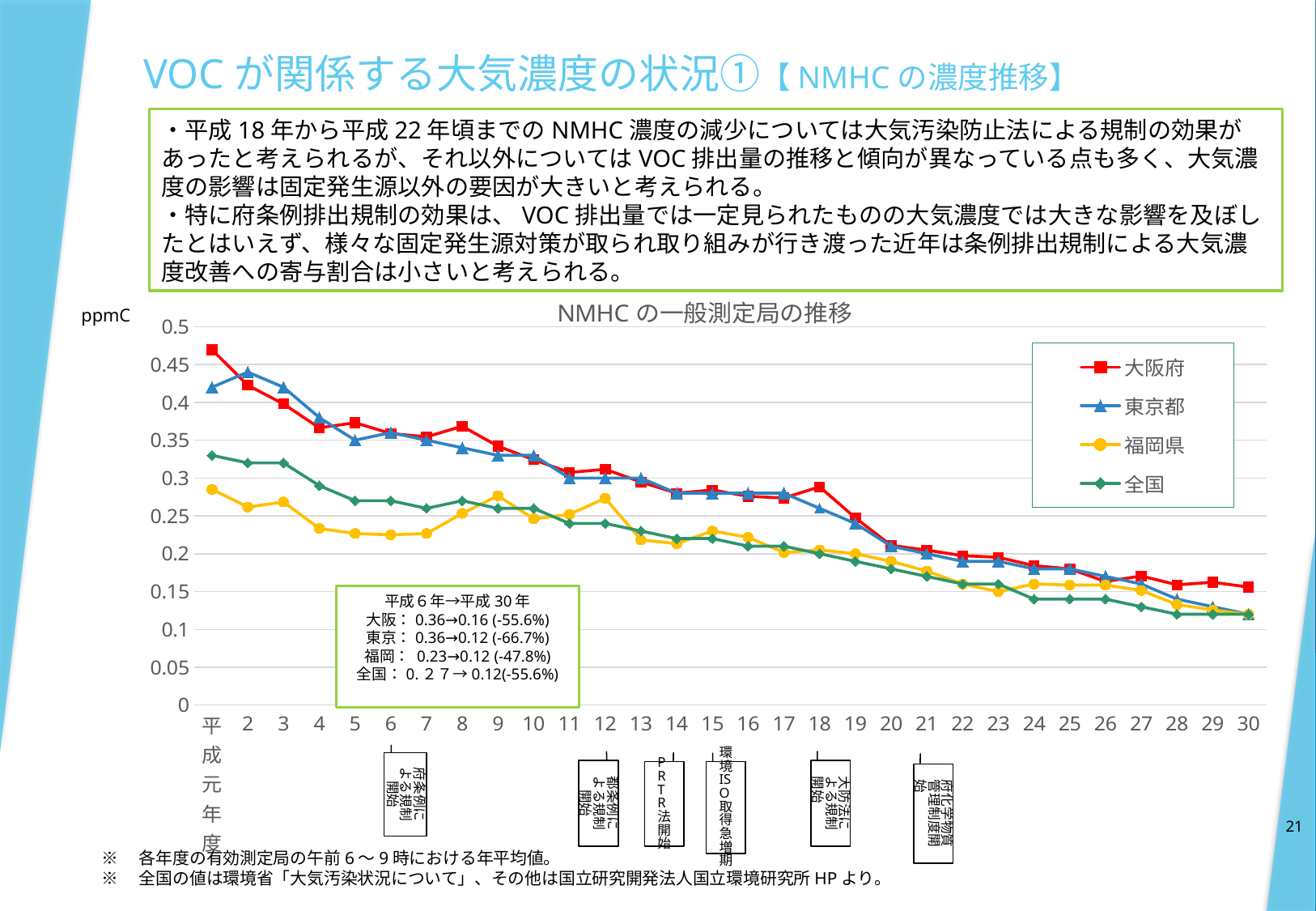
Which series has the highest value in 平成元年度? 大阪府 Using the values in the annotation box, what is the difference between 大阪 and 東京 in 平成30年? 0.04 What is the title of the chart? NMHCの一般測定局の推移 Which series has the lowest value in 平成元年度? 福岡県 According to the annotation box, what percentage change did 福岡 show from 平成6年 to 平成30年? -47.8% According to the annotation box, what was the value for 大阪 in 平成30年? 0.16 What kind of chart is shown on the slide? line chart How many series does the legend of the chart list? 4 What unit is shown for the vertical axis of the chart? ppmC According to the annotation box, what was the value for 東京 in 平成6年? 0.36 Is the value for 大阪府 in 平成元年度 greater or less than 0.45? greater Overall, do the NMHC concentrations rise or fall from 平成元年度 to 平成30年度? fall